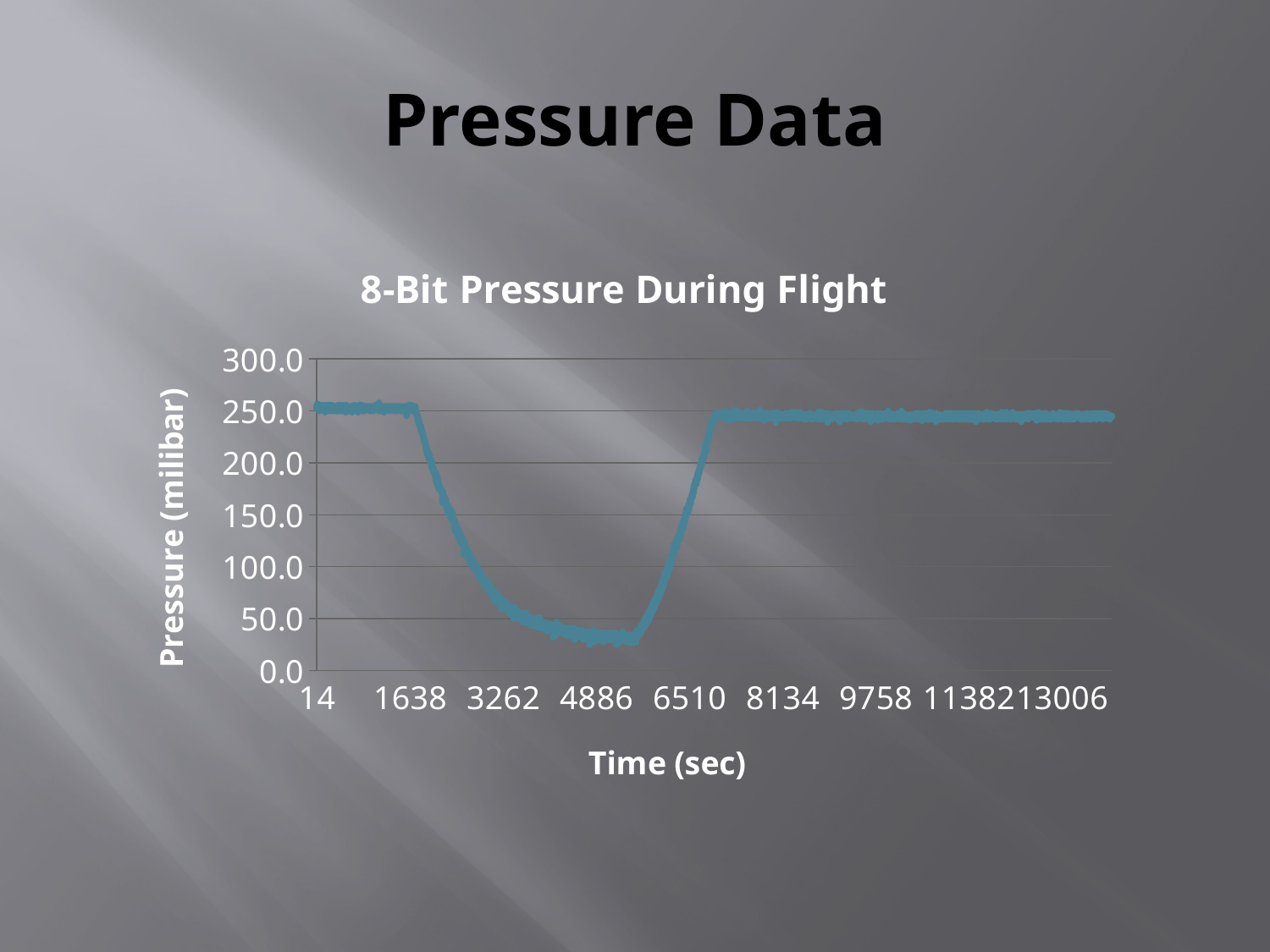
Around which x-axis tick does the pressure reach its lowest values? 4886 Does the pressure rise or fall between time 6510 and time 8134? rise What is the label of the vertical axis of the chart? Pressure (milibar) What is the title of the chart? 8-Bit Pressure During Flight Which is larger, the pressure at time 14 or the pressure at time 4886? time 14 Is the pressure value at time 1638 greater or less than 150? greater Is the pressure value at time 4886 greater or less than 100? less How many tick labels are shown on the Time (sec) axis? 9 Does the pressure rise or fall between time 1638 and time 4886? fall What kind of chart is shown on the slide? line chart Is the pressure value at time 14 greater or less than 200? greater